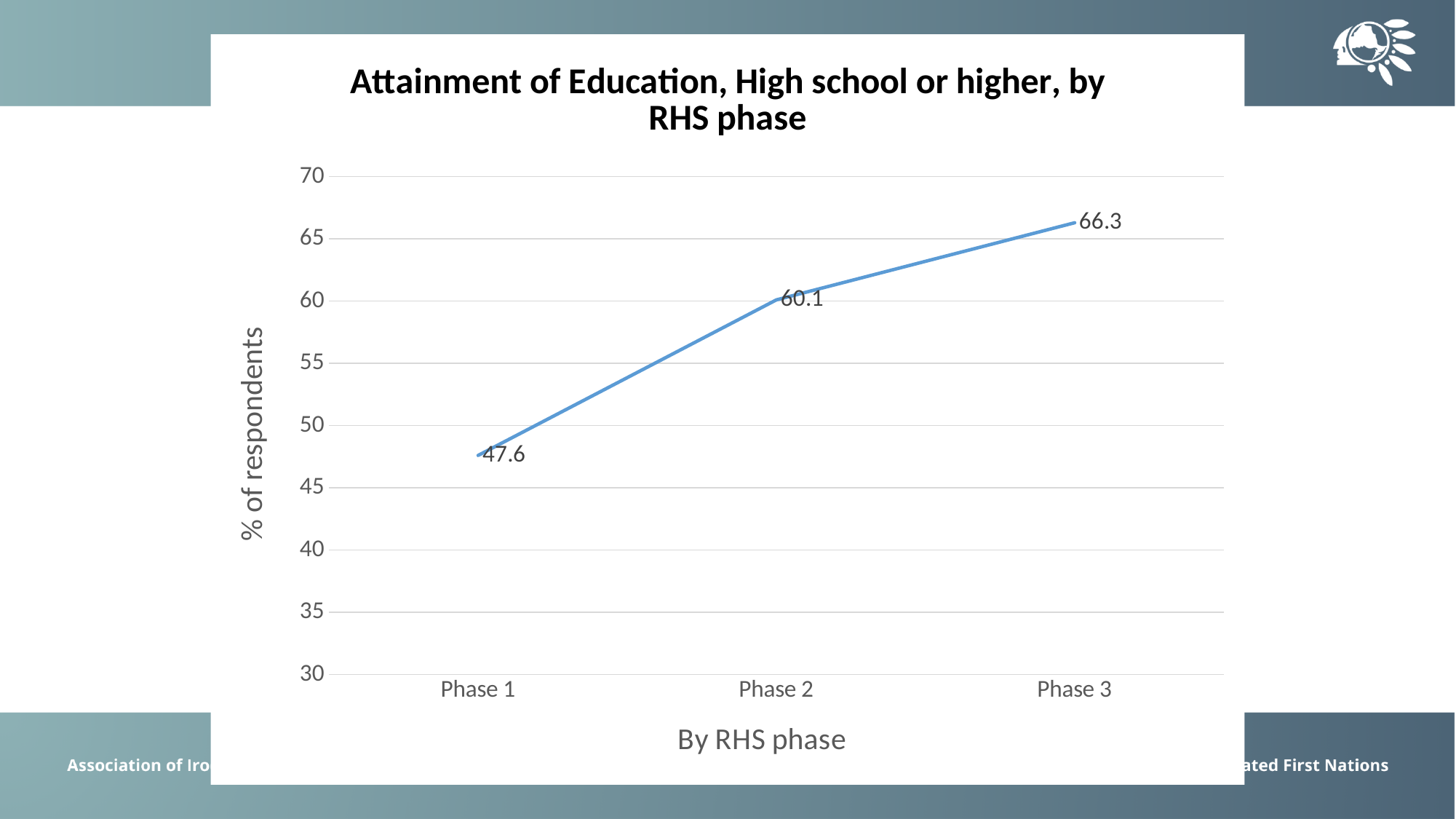
What is the value for Phase 2? 60.1 How many phases are plotted on the x axis? 3 Which is larger, the value for Phase 2 or Phase 3? Phase 3 What is the difference between the values for Phase 3 and Phase 1? 18.7 Is the value for Phase 1 greater or less than 50? less What is the value for Phase 1? 47.6 Which phase has the highest value? Phase 3 What is the value for Phase 3? 66.3 Which phase has the lowest value? Phase 1 What kind of chart is shown? line chart Do the values rise or fall from Phase 1 to Phase 3? rise What is the difference between the values for Phase 2 and Phase 1? 12.5